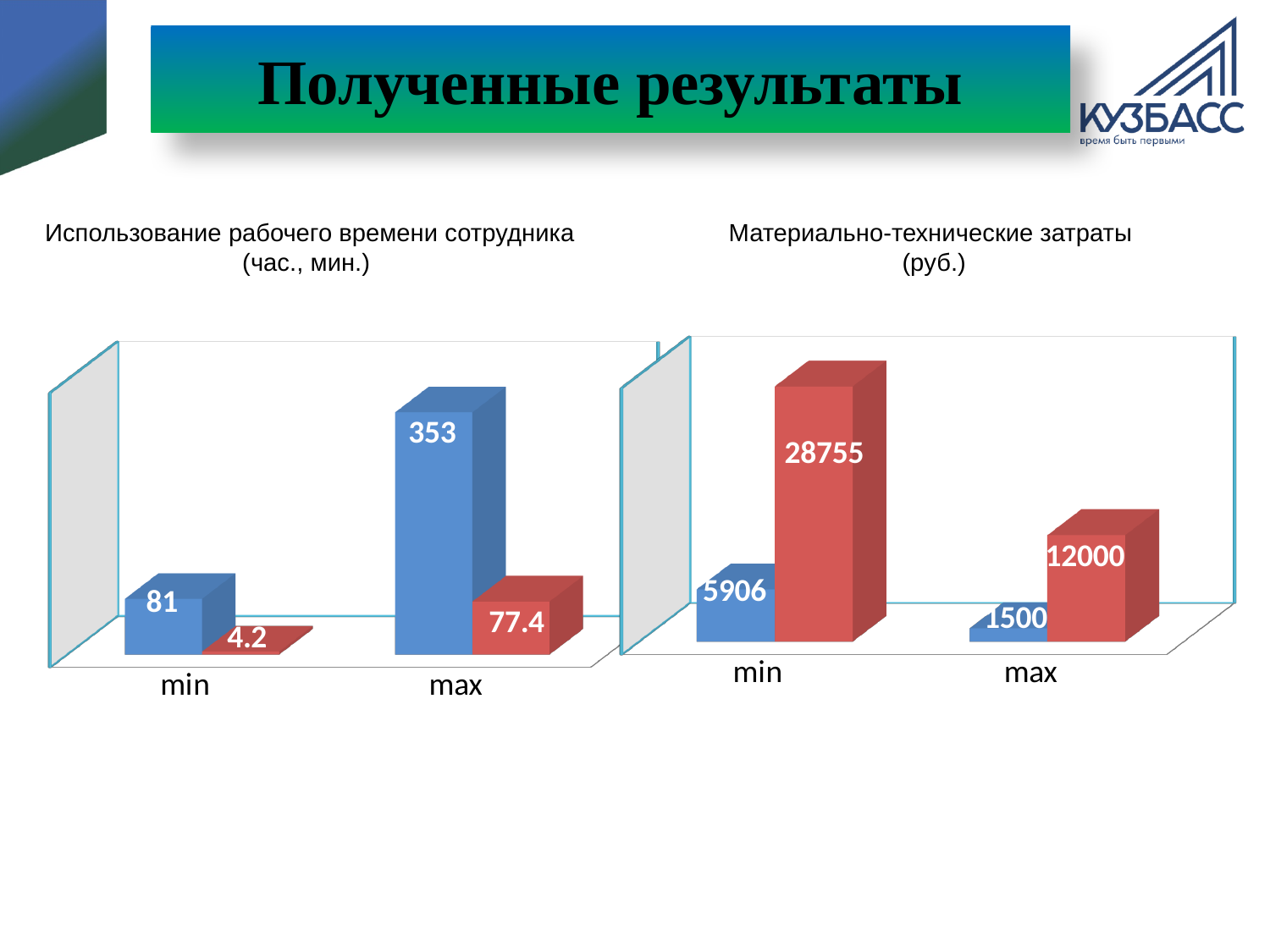
In the left chart (Использование рабочего времени сотрудника), what is the value of the blue bar for max? 353 In the right chart (Материально-технические затраты), which bar is the tallest? the red bar for min (28755) In the right chart (Материально-технические затраты), what is the difference between the red bar for min and the red bar for max? 16755 In the left chart (Использование рабочего времени сотрудника), which bar is the lowest? the red bar for min (4.2) In the right chart (Материально-технические затраты), what is the value of the blue bar for max? 1500 In the left chart (Использование рабочего времени сотрудника), what is the difference between the blue bar for max and the blue bar for min? 272 In the left chart (Использование рабочего времени сотрудника), what is the value of the blue bar for min? 81 In the right chart (Материально-технические затраты), which is larger for min: the blue bar or the red bar? the red bar In the left chart (Использование рабочего времени сотрудника), what is the value of the red bar for min? 4.2 What type of chart is the right chart (Материально-технические затраты)? bar chart In the right chart (Материально-технические затраты), what is the value of the red bar for min? 28755 How many categories are shown on the x axis of the left chart (Использование рабочего времени сотрудника)? 2